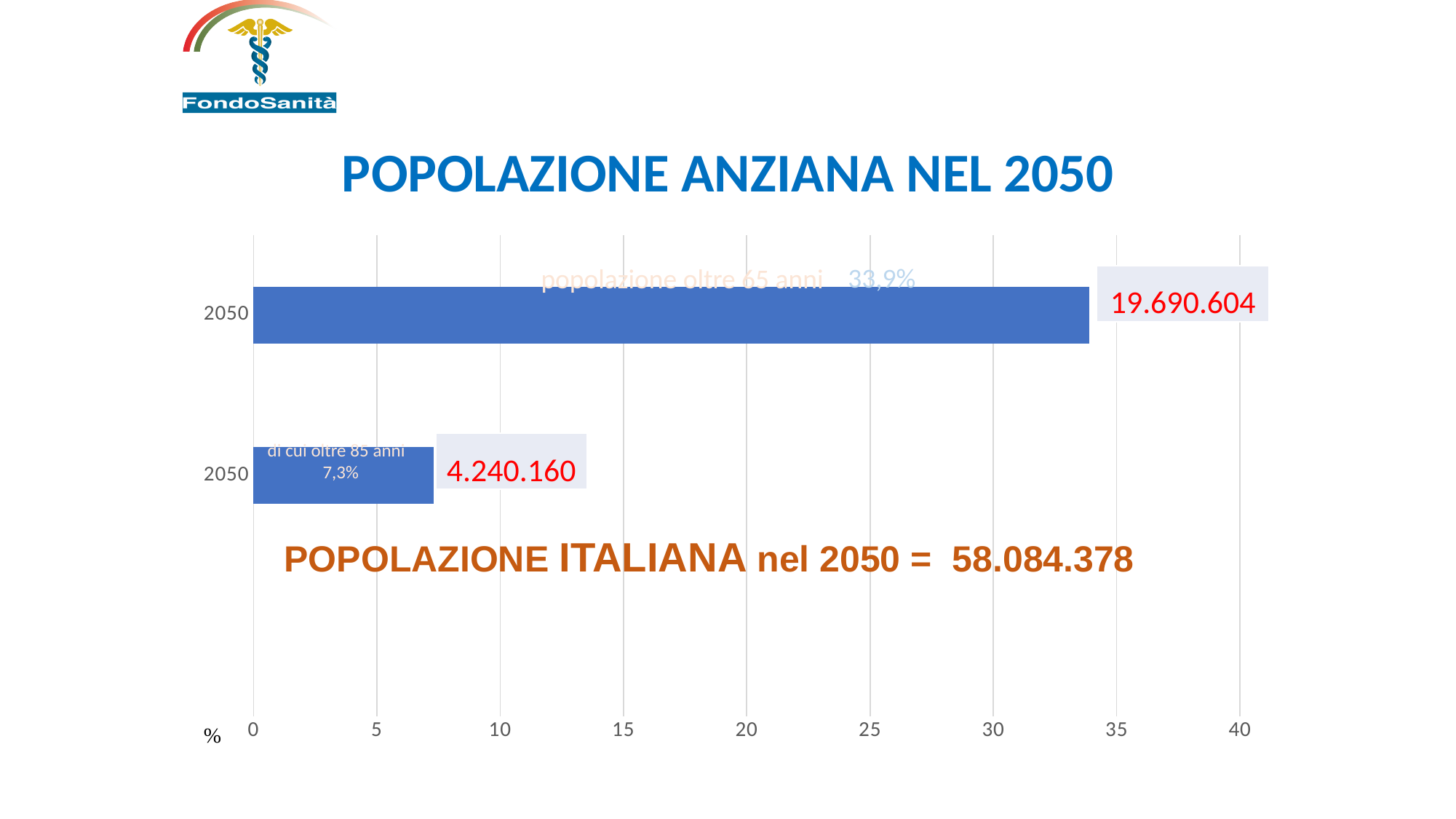
What is the difference in percentage points between 'popolazione oltre 65 anni' and 'di cui oltre 85 anni'? 26,6 How many bars are plotted in the chart? 2 What percentage is shown for 'popolazione oltre 65 anni'? 33,9% Is the value for 'popolazione oltre 65 anni' greater or less than 30? greater Is the value for 'di cui oltre 85 anni' greater or less than 10? less What absolute number is shown next to the bar for 'di cui oltre 85 anni'? 4.240.160 Which bar is the longest in the chart? popolazione oltre 65 anni What percentage is shown for 'di cui oltre 85 anni'? 7,3% What is the title of the chart on the slide? POPOLAZIONE ANZIANA NEL 2050 What kind of chart is shown on the slide? bar chart What absolute number is shown next to the bar for 'popolazione oltre 65 anni'? 19.690.604 Which bar is the shortest in the chart? di cui oltre 85 anni